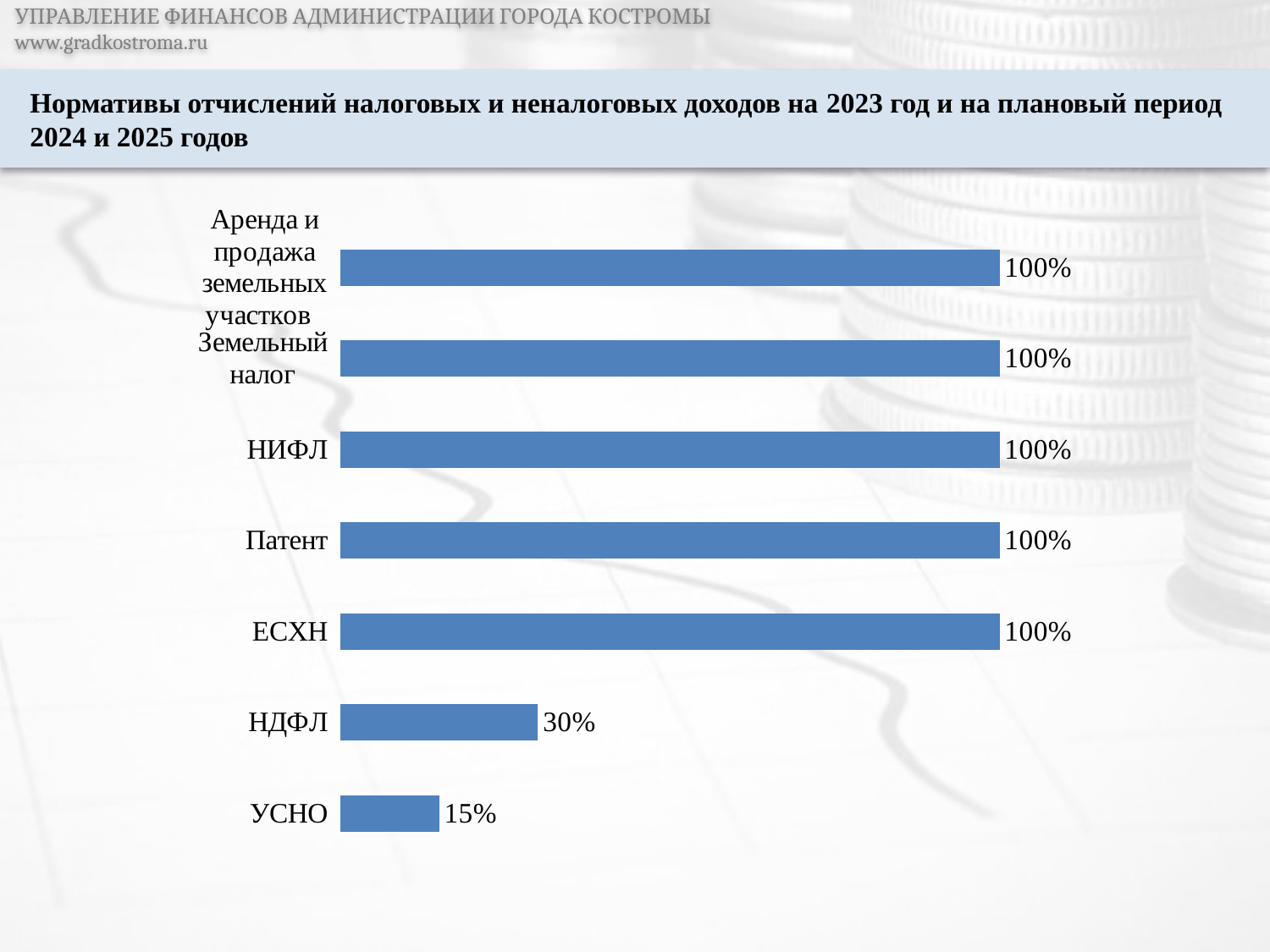
What is the value for НДФЛ? 30% What is the value for УСНО? 15% What kind of chart is shown on the slide? Bar chart What is the value for Земельный налог? 100% What is the difference between the values for ЕСХН and НДФЛ? 70% Which is larger, the value for НИФЛ or the value for НДФЛ? НИФЛ How many categories have a value of 100%? 5 Which category has the lowest value? УСНО What is the difference between the values for НДФЛ and УСНО? 15% How many categories are shown in the chart? 7 Which is larger, the value for НДФЛ or the value for УСНО? НДФЛ What is the value for Патент? 100%